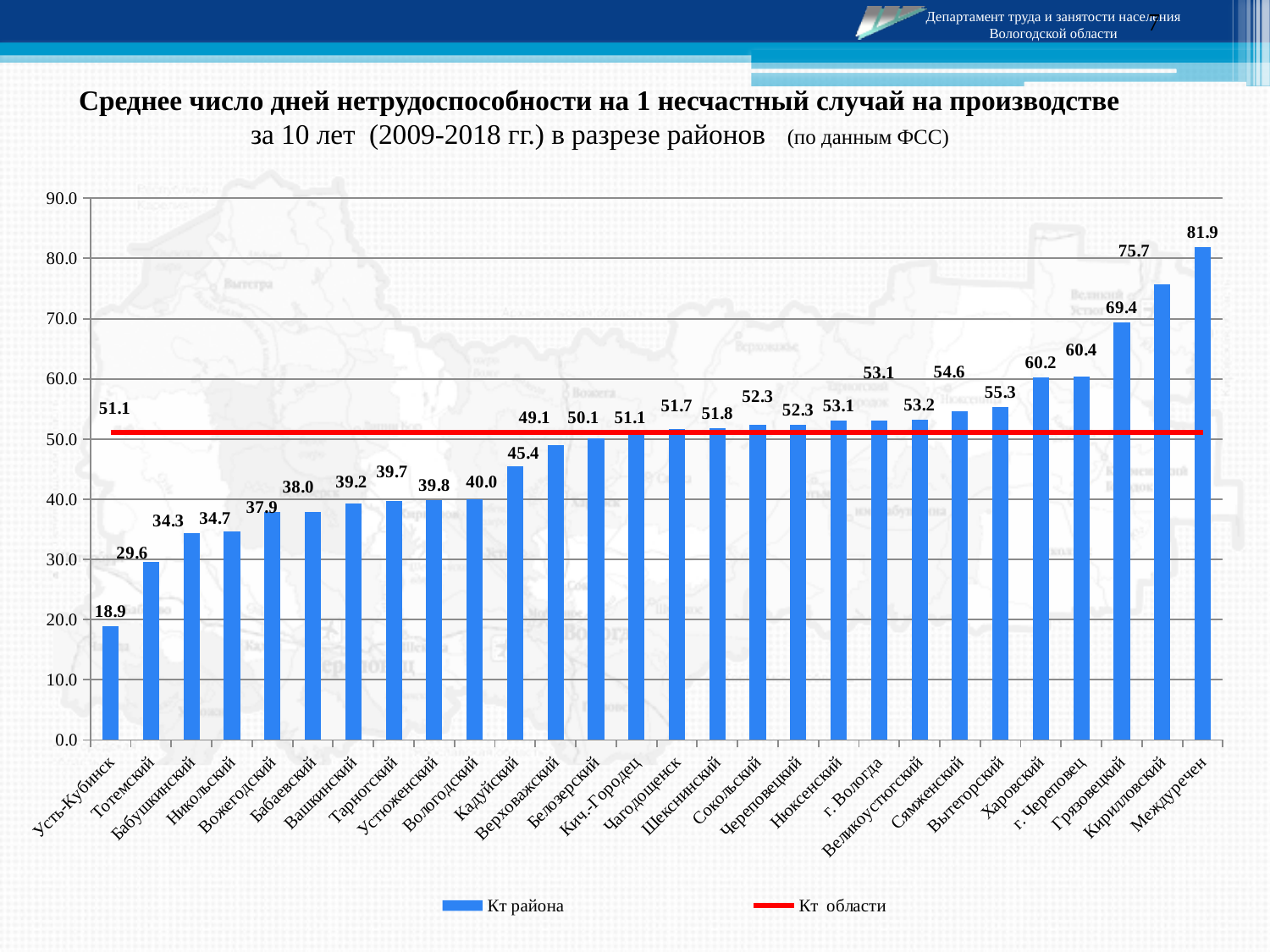
What is the value for Кадуйский? 45.4 Which is larger, the value for Грязовецкий or the value for Кирилловский? Кирилловский What is the value for Усть-Кубинский? 18.9 What is the value for Междуречен? 81.9 How many series does the legend list? 2 What is the value for Кирилловский? 75.7 What type of chart is shown on the slide? Bar chart What is the difference between the values for Междуречен and Усть-Кубинский? 63.0 Which district has the lowest average number of days of incapacity per accident? Усть-Кубинск How many districts are shown on the x axis? 28 Which district has the highest average number of days of incapacity per accident? Междуречен What is the value of the regional level (Кт области) shown by the red line? 51.1